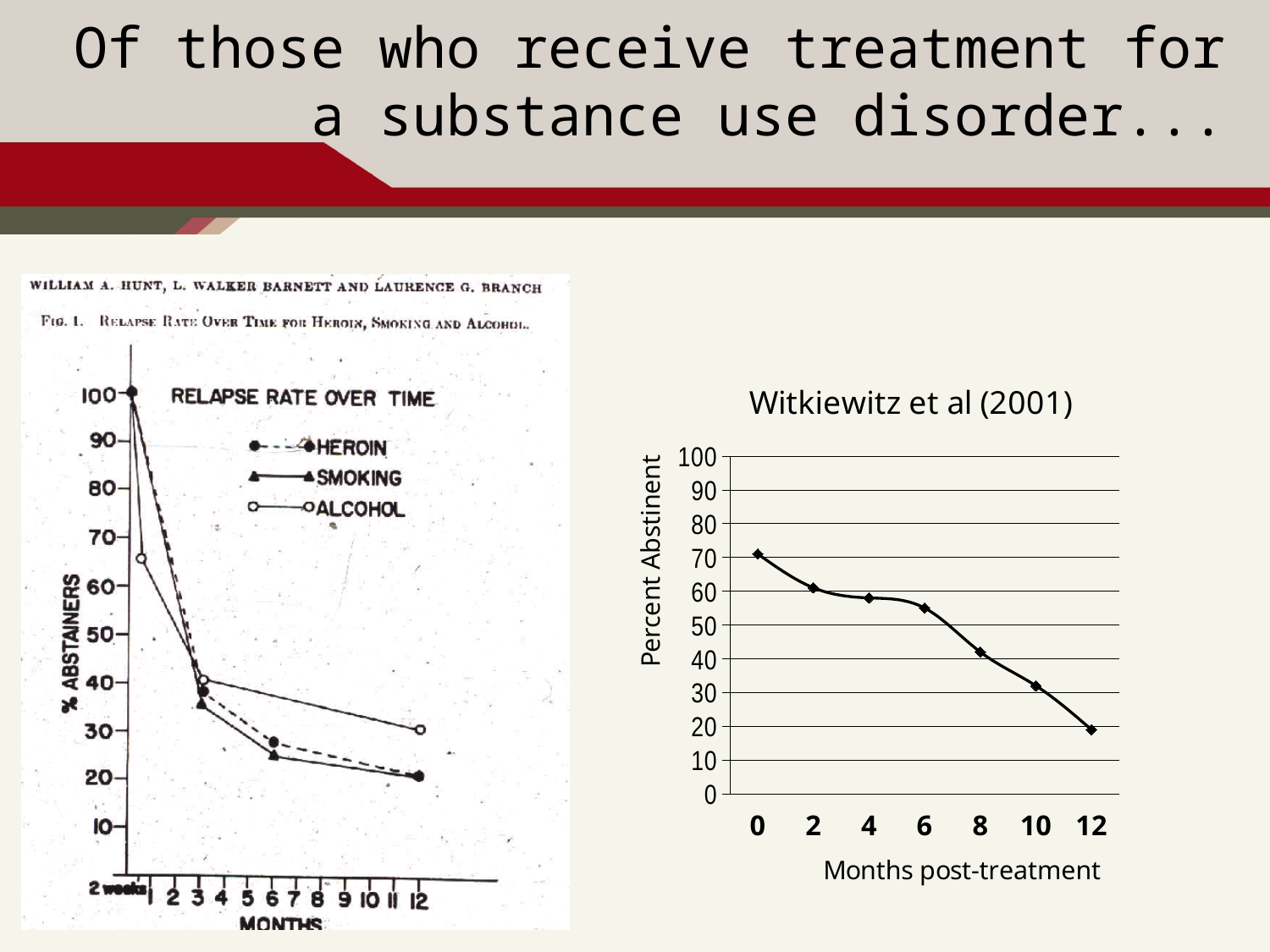
In the Witkiewitz et al (2001) chart, at which month is Percent Abstinent lowest? 12 What kind of chart is the Witkiewitz et al (2001) chart on the right? line chart In the Witkiewitz et al (2001) chart, does Percent Abstinent rise or fall as months post-treatment increase? fall In the Witkiewitz et al (2001) chart, is the Percent Abstinent at 8 months greater or less than 50? less In the Relapse Rate Over Time chart on the left, which series has the highest % abstainers at 12 months? Alcohol In the Witkiewitz et al (2001) chart, is the Percent Abstinent at 12 months greater or less than 30? less In the Relapse Rate Over Time chart on the left, is the % abstainers for Alcohol at 12 months greater or less than 20? greater In the Relapse Rate Over Time chart on the left, how many series does the legend list? 3 In the Witkiewitz et al (2001) chart, what is the label of the y axis? Percent Abstinent In the Witkiewitz et al (2001) chart, how many data points are plotted? 7